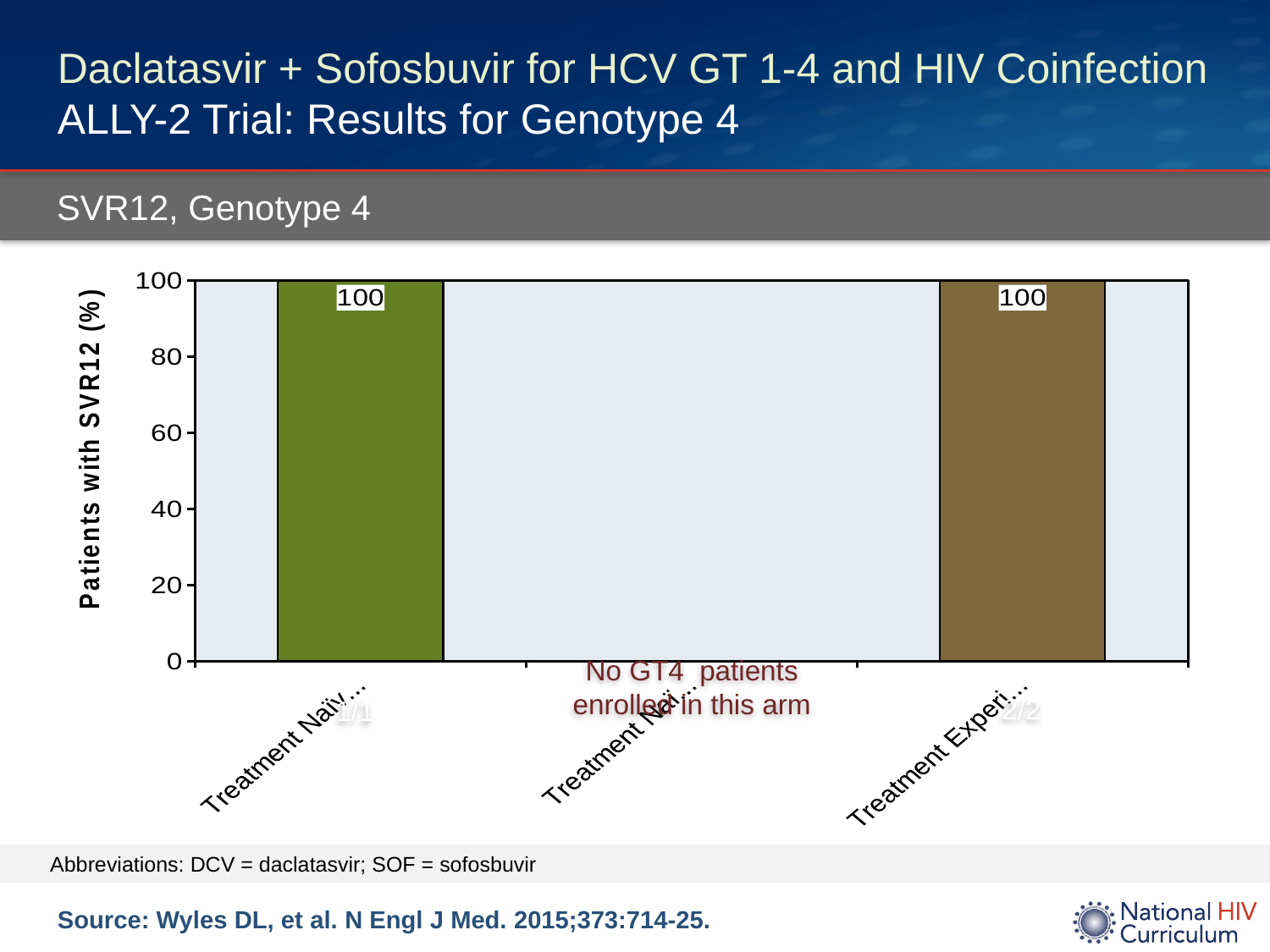
What is the label of the y axis? Patients with SVR12 (%) What kind of chart is shown on the slide? bar chart What is the difference between the values of the leftmost and rightmost bars? 0 What does the text in the middle category position of the chart say? No GT4 patients enrolled in this arm What is the value shown on the leftmost (green) bar? 100 What is the value shown on the rightmost (brown) bar? 100 What is the maximum value shown on the y axis? 100 Is the value for the rightmost bar greater or less than 80? greater How many bars are plotted in the chart? 2 Is the value of the leftmost bar larger than, smaller than, or equal to the value of the rightmost bar? equal How many category positions are shown along the x axis? 3